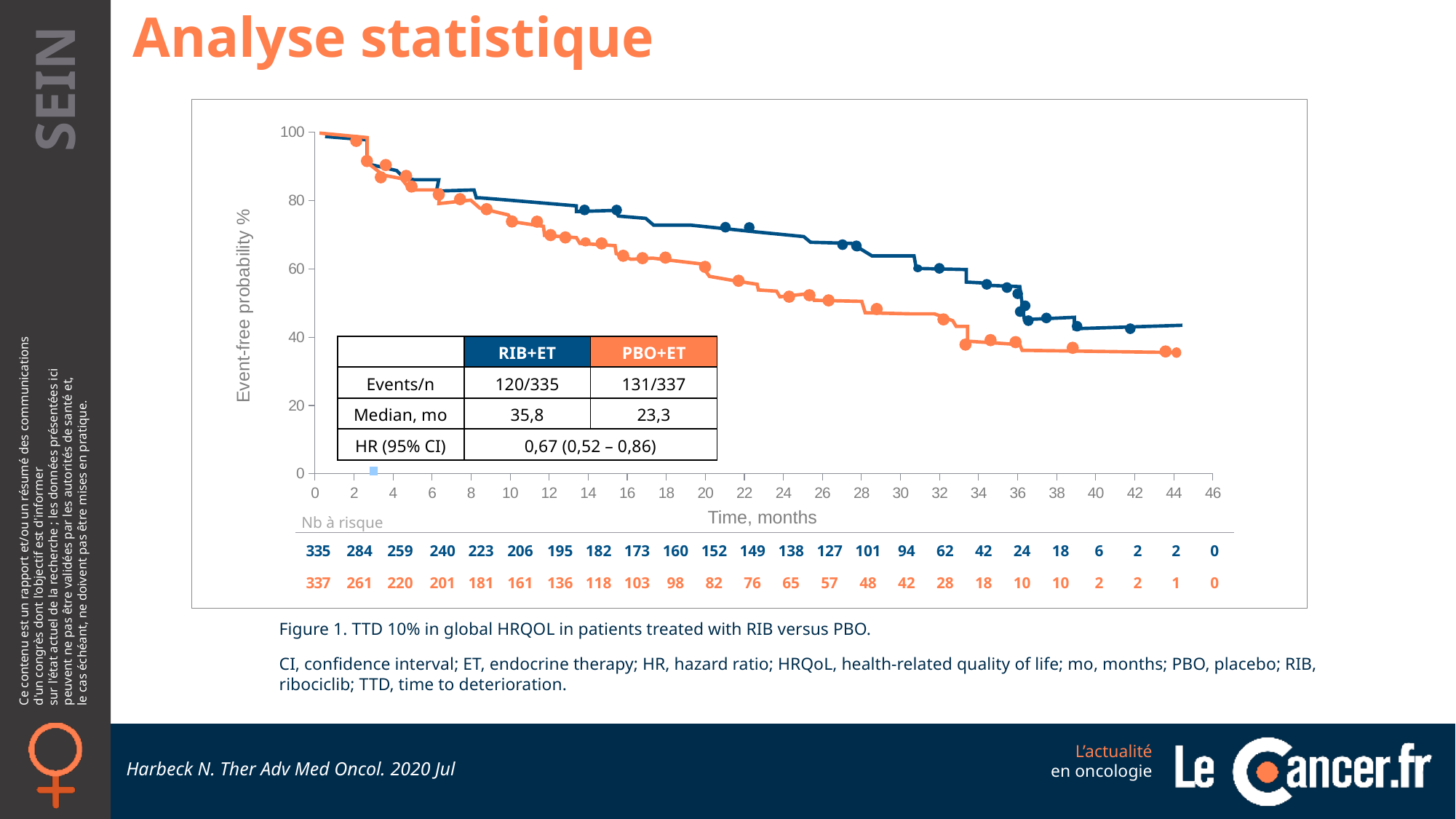
What is the difference between the number of RIB+ET and PBO+ET patients at risk at 10 months? 45 What is the median time (months) for the PBO+ET group according to the table on the chart? 23,3 What is the Events/n value for the RIB+ET group? 120/335 How many RIB+ET patients were at risk at 20 months? 152 How many PBO+ET patients were at risk at 0 months? 337 What is the HR (95% CI) reported on the chart? 0,67 (0,52 – 0,86) At 20 months, is the event-free probability for the RIB+ET curve greater or less than 60%? greater Which group has the higher median time, RIB+ET or PBO+ET? RIB+ET What is the median time (months) for the RIB+ET group according to the table on the chart? 35,8 Do the event-free probability curves rise or fall as time increases? fall How many treatment groups (series) are plotted on the chart? 2 What kind of chart is shown on the slide? line chart